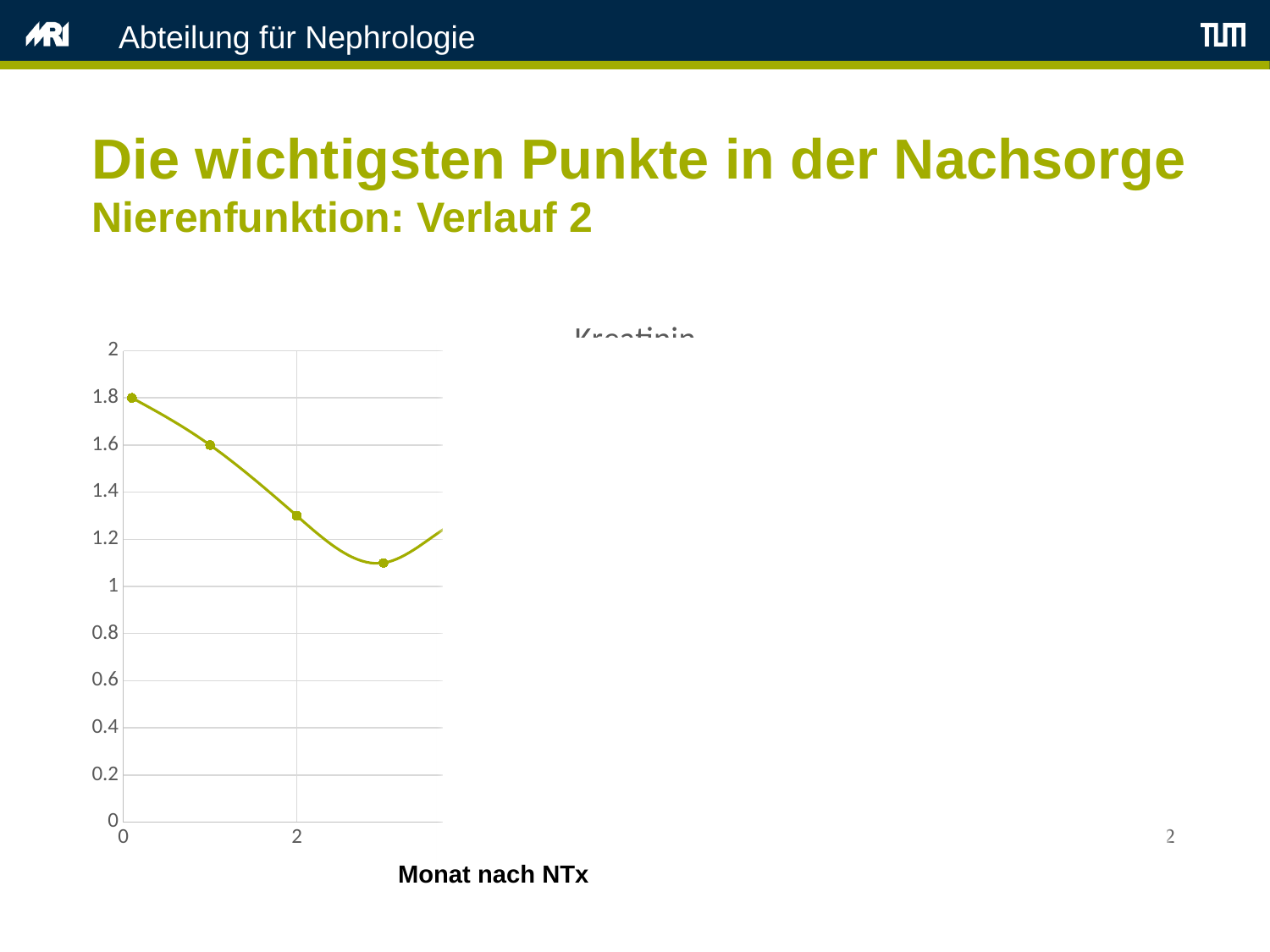
What is the title of the x axis? Monat nach NTx Which plotted point has the highest value? the first point, at month 0 Is the value of the fourth plotted point greater or less than 1.2? less What is the value of the first plotted point, at month 0? 1.8 Which is larger, the value at month 0 or the value at month 2? month 0 What is the difference between the first and second plotted points? 0.2 Do the plotted values rise or fall from the first point to the fourth point along the x axis? fall Is the value of the third plotted point greater or less than 1.4? less What kind of chart is shown on the slide? line chart Is the value of the fourth plotted point greater or less than 1? greater What is the value of the second plotted point? 1.6